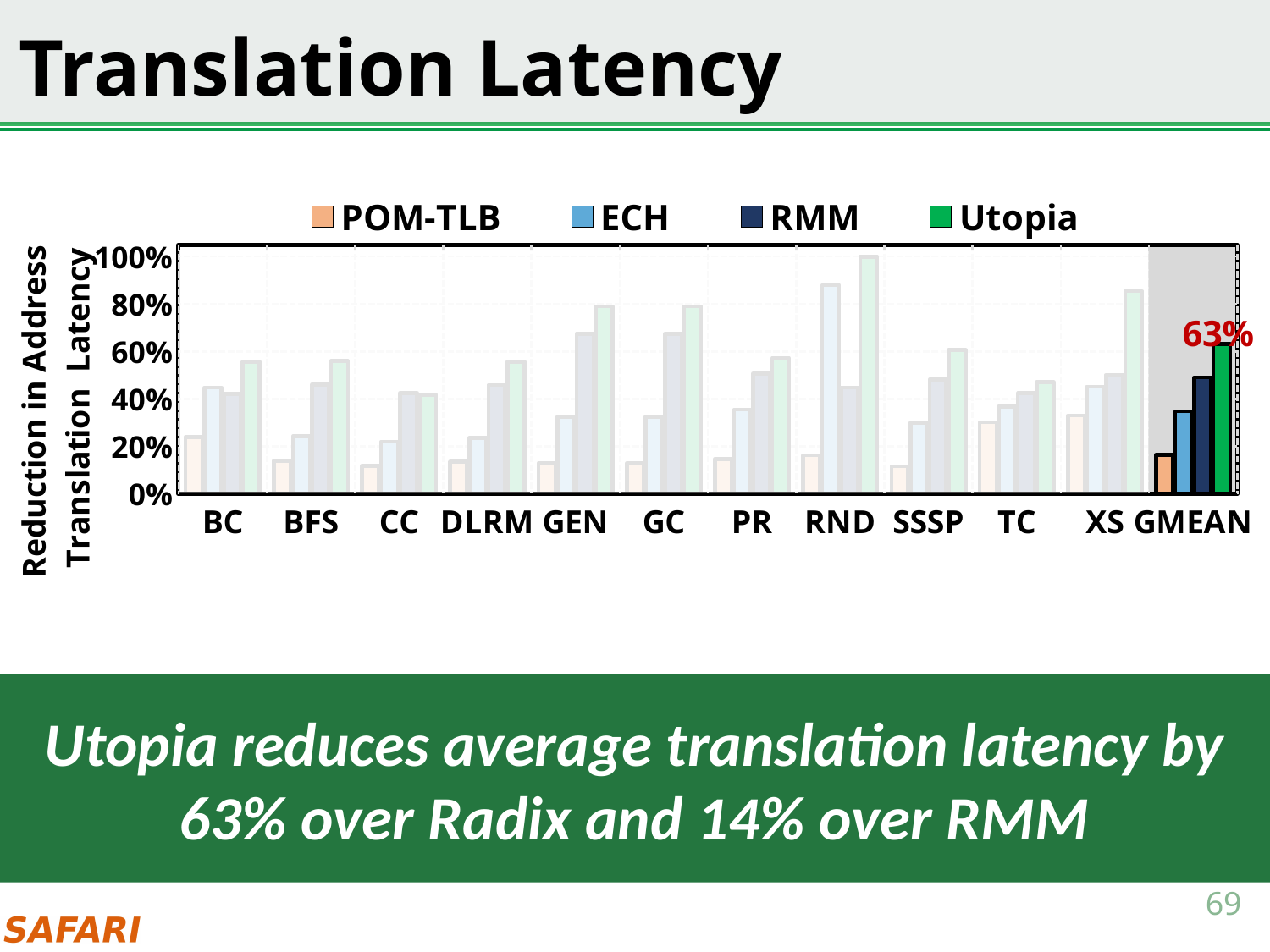
Is the Utopia value for RND greater or less than 80%? greater How many categories are shown along the x axis? 12 Which series has the lowest value for GMEAN? POM-TLB Which series has the highest value for GMEAN? Utopia Is the POM-TLB value for BC greater or less than 40%? less What is the label on the y axis? Reduction in Address Translation Latency What is the Utopia value for GMEAN? 63% How many series does the legend list? 4 What kind of chart is shown on the slide? bar chart For RND, which is larger: the ECH value or the RMM value? ECH For which category is the Utopia value highest? RND